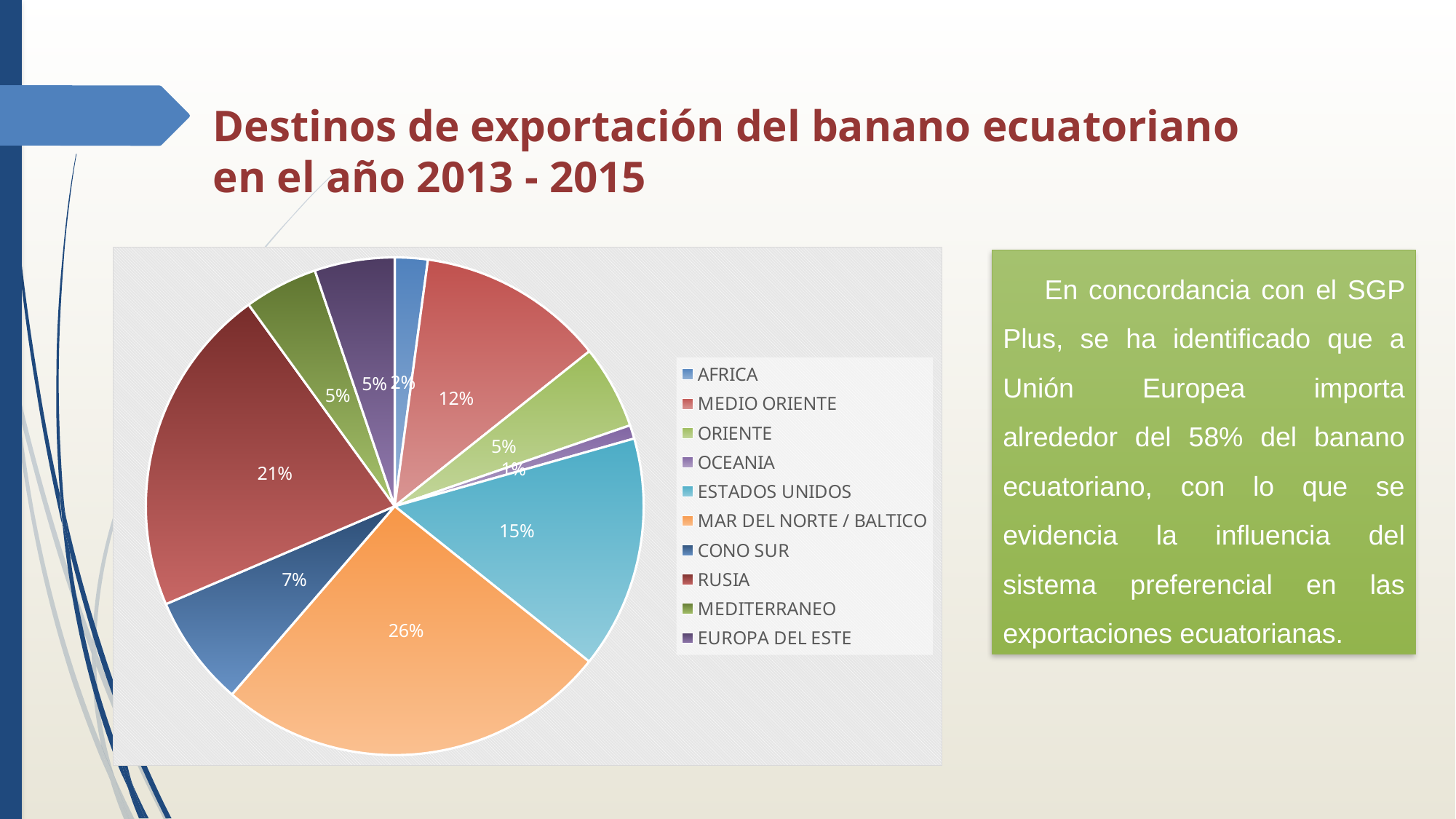
What share of the pie does ESTADOS UNIDOS have? 15% What is the difference in percentage points between the shares of MAR DEL NORTE / BALTICO and RUSIA? 5 What kind of chart is shown on the slide? Pie chart Which destination has the largest share of the pie? MAR DEL NORTE / BALTICO What share of the pie does CONO SUR have? 7% How many destinations does the legend list? 10 What is the title of the slide containing the pie chart? Destinos de exportación del banano ecuatoriano en el año 2013 - 2015 Which has a larger share, ESTADOS UNIDOS or MEDIO ORIENTE? ESTADOS UNIDOS What share of the pie does RUSIA have? 21% Which destination has the smallest share of the pie? OCEANIA